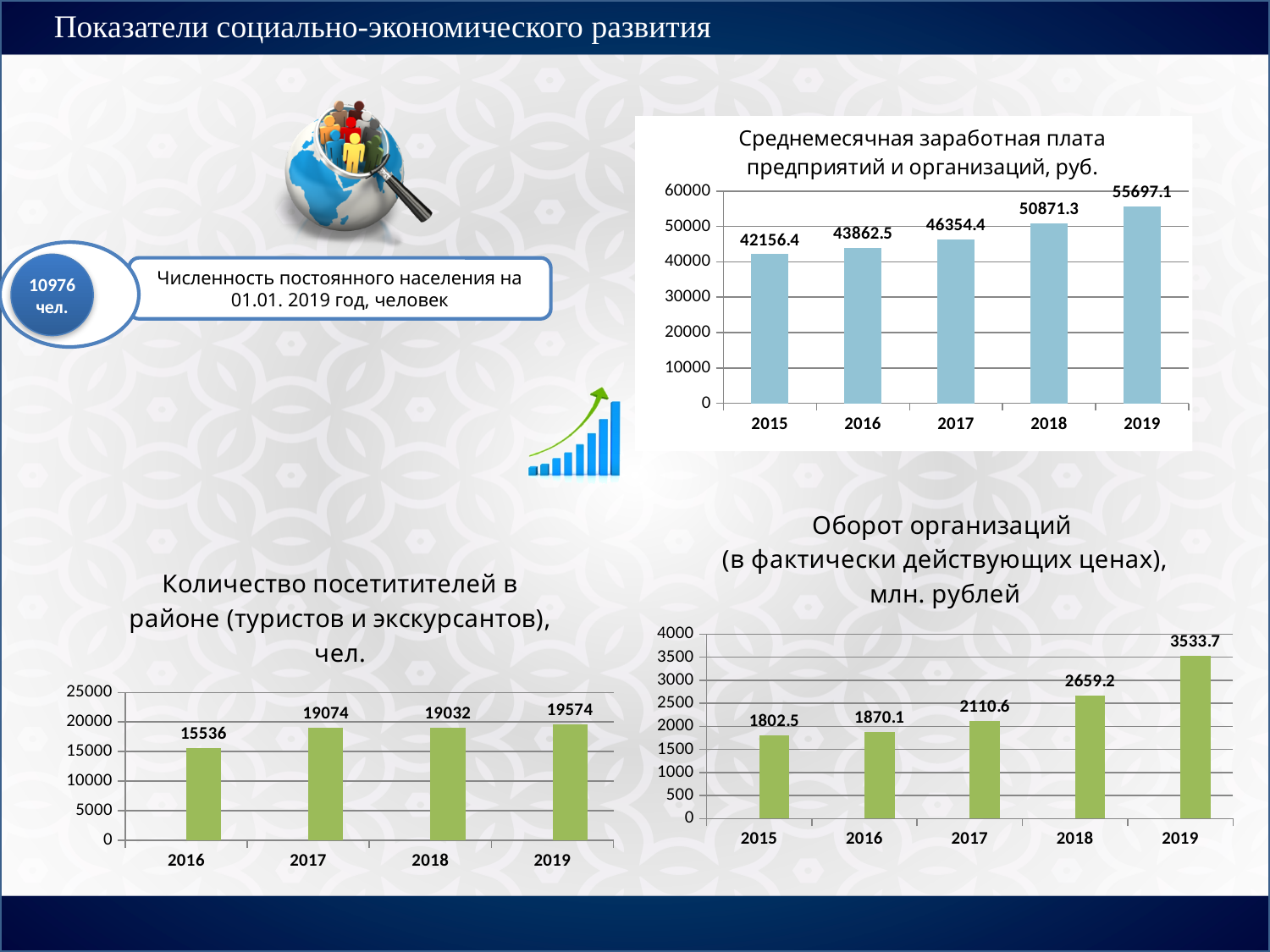
In the chart 'Оборот организаций (в фактически действующих ценах), млн. рублей', what is the difference between the 2018 and 2017 values? 548.6 In the chart 'Количество посетититителей в районе (туристов и экскурсантов), чел.', how many years are shown? 4 In the chart 'Количество посетититителей в районе (туристов и экскурсантов), чел.', what is the value for 2018? 19032 In the chart 'Среднемесячная заработная плата предприятий и организаций, руб.', which year has the highest value? 2019 What kind of chart is 'Оборот организаций (в фактически действующих ценах), млн. рублей'? bar chart In the chart 'Количество посетититителей в районе (туристов и экскурсантов), чел.', what is the difference between the 2019 and 2016 values? 4038 In the chart 'Оборот организаций (в фактически действующих ценах), млн. рублей', what is the value for 2018? 2659.2 In the chart 'Среднемесячная заработная плата предприятий и организаций, руб.', what is the value for 2017? 46354.4 In the chart 'Оборот организаций (в фактически действующих ценах), млн. рублей', which is larger, the value for 2016 or the value for 2017? 2017 In the chart 'Среднемесячная заработная плата предприятий и организаций, руб.', what is the difference between the 2019 and 2015 values? 13540.7 In the chart 'Количество посетититителей в районе (туристов и экскурсантов), чел.', which year has the lowest value? 2016 In the chart 'Среднемесячная заработная плата предприятий и организаций, руб.', do the values rise or fall from 2015 to 2019? rise